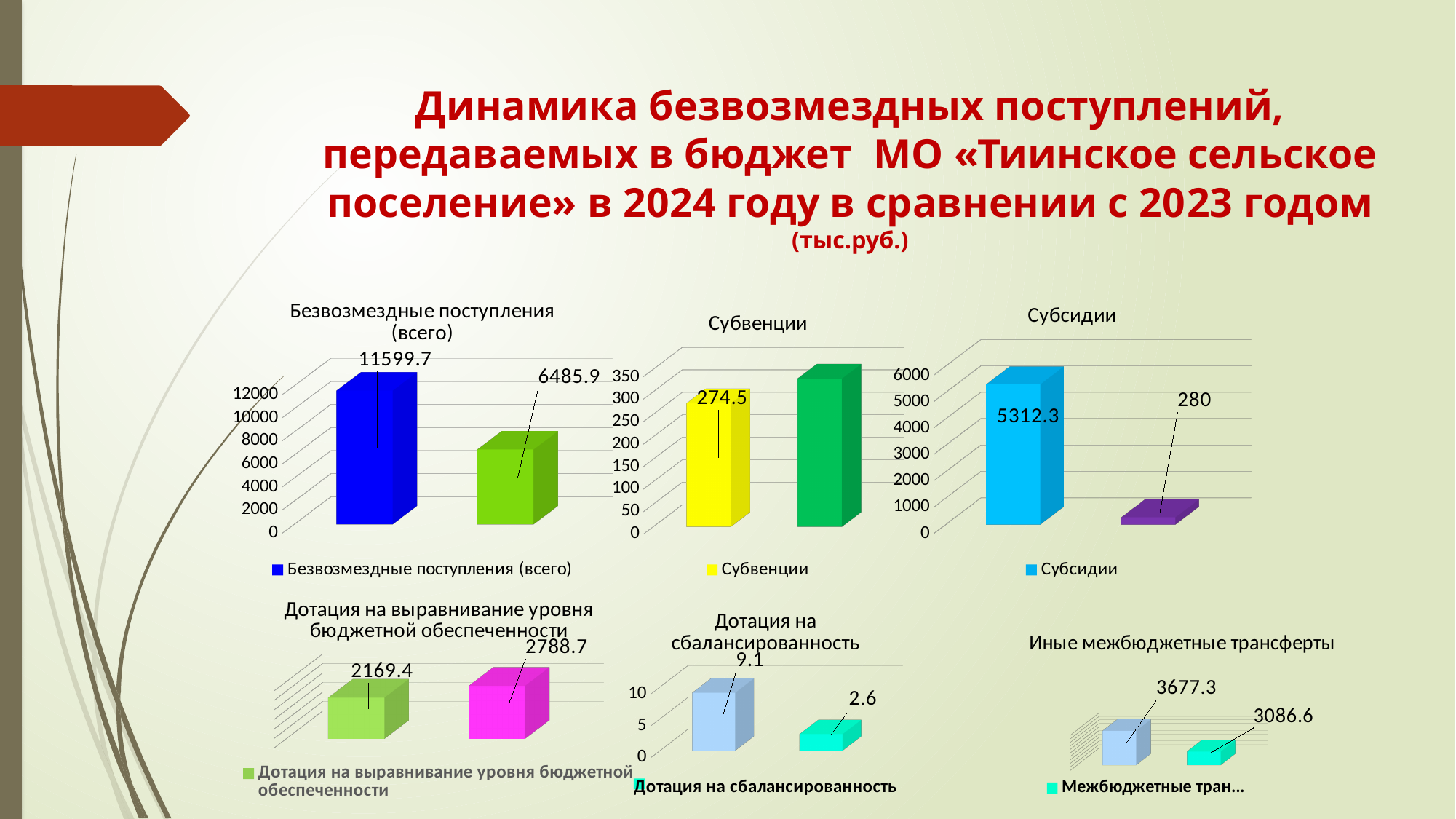
In the 'Субвенции' chart, what value is labelled on the yellow bar? 274.5 How many separate charts are shown on the slide? 6 What type of chart is the 'Безвозмездные поступления (всего)' chart? bar chart How many bars are plotted in the 'Иные межбюджетные трансферты' chart? 2 In the 'Субсидии' chart, what value is labelled on the light blue bar? 5312.3 In the 'Безвозмездные поступления (всего)' chart, what is the difference between the blue bar (11599.7) and the green bar (6485.9)? 5113.8 In the 'Дотация на выравнивание уровня бюджетной обеспеченности' chart, which bar is larger, the green one or the pink one? the pink one (2788.7) In the 'Дотация на сбалансированность' chart, which bar has the highest value? the left (light blue) bar, 9.1 In the 'Субвенции' chart, is the value of the green (right) bar greater or less than 300? greater In the 'Дотация на сбалансированность' chart, what value is labelled on the right (cyan) bar? 2.6 In the 'Иные межбюджетные трансферты' chart, what is the difference between the two labelled values? 590.7 In the 'Субсидии' chart, how much larger is the light blue bar than the purple bar? 5032.3